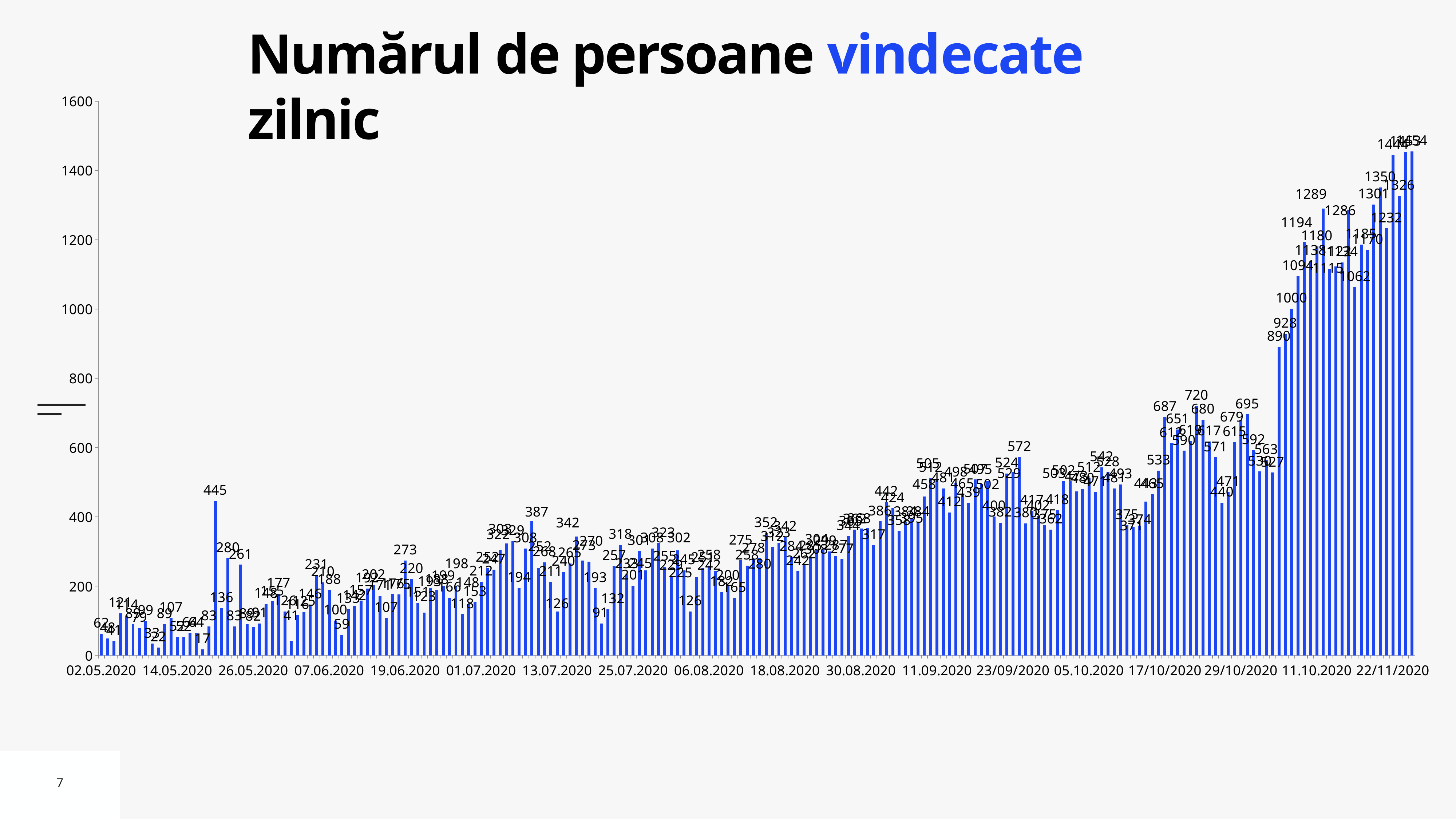
What is the title of the chart? Numărul de persoane vindecate zilnic What is the difference between the bars labelled 720 and 687 in October? 33 Which is larger, the bar labelled 445 in May or the bar labelled 387 in July? 445 Is the highest bar on the chart greater or less than 1400? greater Overall, do the values rise or fall from left to right along the x axis? rise What kind of chart is shown on the slide? bar chart What is the difference between the bars labelled 1350 and 1289 in November? 61 What is the maximum value shown on the vertical axis? 1600 What is the lowest value labelled on the chart? 17 Is the bar labelled 890 greater or less than 800? greater What is the highest value labelled among the bars in May 2020 (between 02.05.2020 and 26.05.2020)? 445 Which is larger, the bar labelled 572 or the bar labelled 542? 572